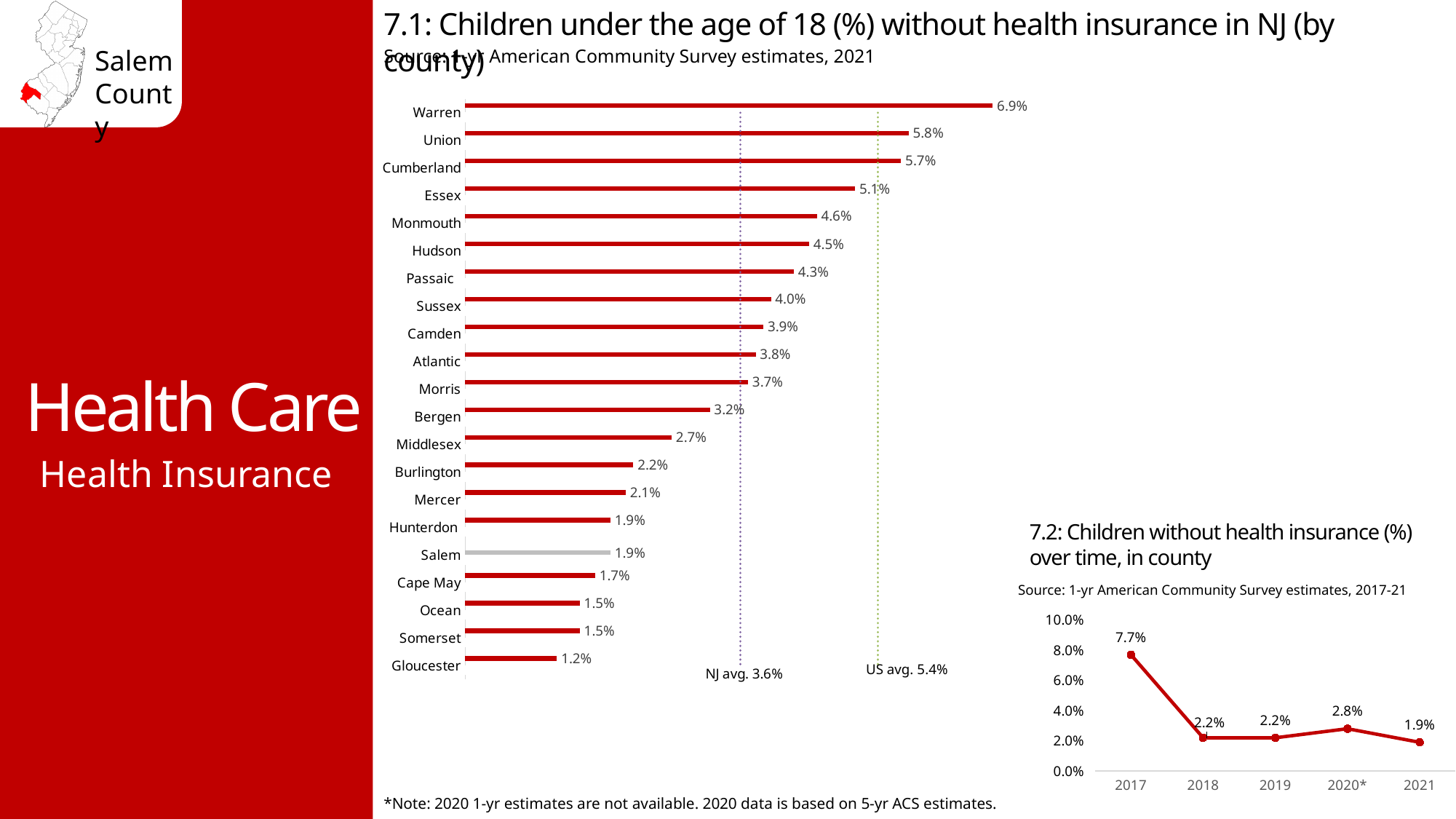
In chart 7.1, which is larger, the value for Cumberland or the value for Essex? Cumberland In chart 7.1, what is the NJ average shown by the dotted line? 3.6% In chart 7.2, which year has the highest value? 2017 What kind of chart is chart 7.1? Bar chart In chart 7.2, how many data points are plotted? 5 In chart 7.1, which county has the highest percentage of children without health insurance? Warren In chart 7.2, what is the difference between the values for 2020* and 2021? 0.9% In chart 7.2, what is the value for 2017? 7.7% In chart 7.1, what is the value for Salem? 1.9% In chart 7.1, how many counties are shown? 21 In chart 7.1, what is the difference between the values for Warren and Gloucester? 5.7% In chart 7.1, which county has the lowest percentage of children without health insurance? Gloucester